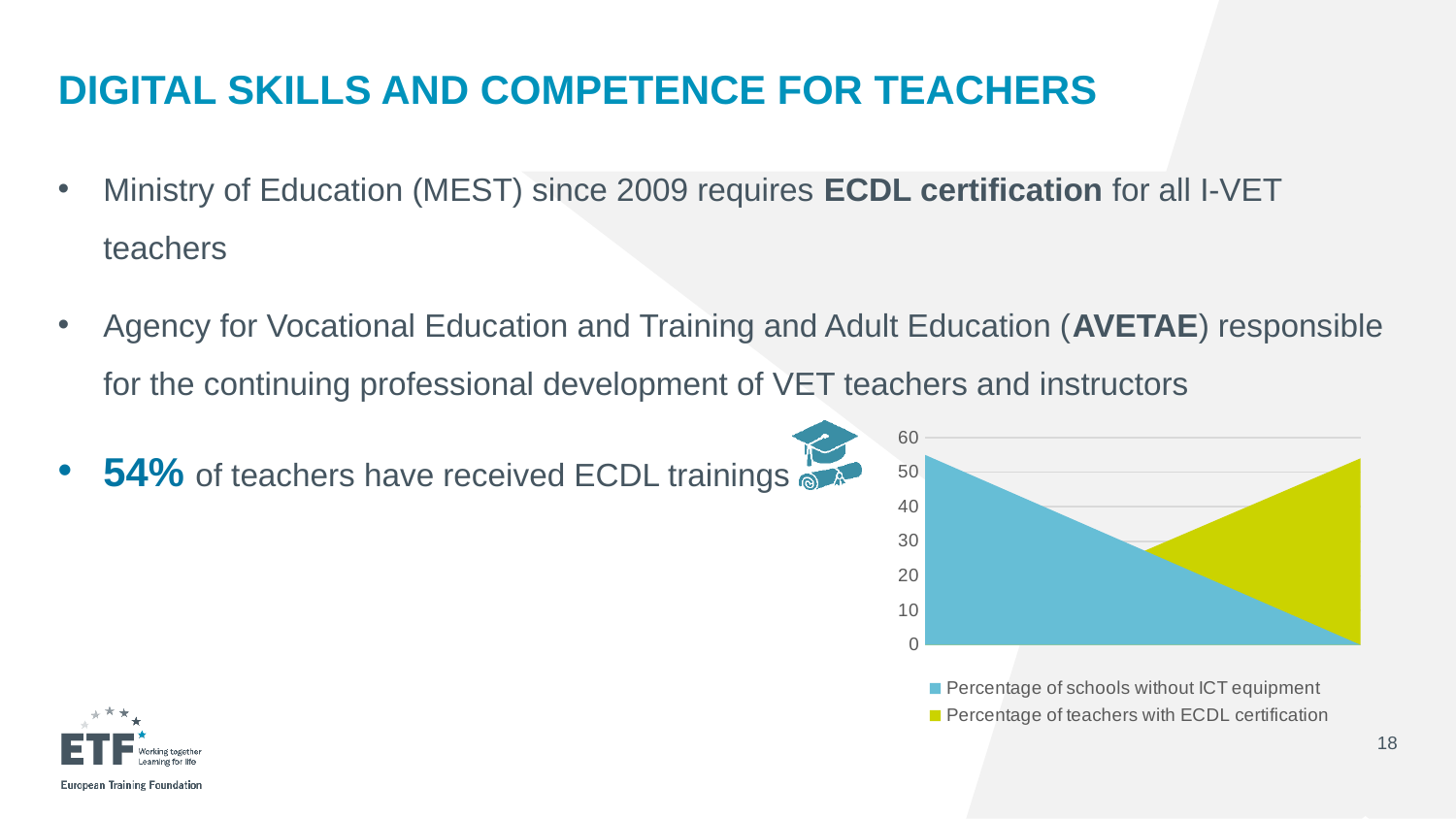
At the right edge of the chart, which series has the larger value: 'Percentage of schools without ICT equipment' or 'Percentage of teachers with ECDL certification'? Percentage of teachers with ECDL certification What kind of chart is shown on the slide? area chart Does the 'Percentage of schools without ICT equipment' series rise or fall from left to right? fall Is the ending value of 'Percentage of teachers with ECDL certification' at the right of the chart greater or less than 40? greater Is the starting value of 'Percentage of teachers with ECDL certification' at the left of the chart greater or less than 10? less Is the starting value of 'Percentage of schools without ICT equipment' at the left of the chart greater or less than 40? greater Does the 'Percentage of teachers with ECDL certification' series rise or fall from left to right? rise At the left edge of the chart, which series has the larger value: 'Percentage of schools without ICT equipment' or 'Percentage of teachers with ECDL certification'? Percentage of schools without ICT equipment What colour represents 'Percentage of teachers with ECDL certification' in the chart? yellow-green How many series does the chart legend list? 2 What is the highest value shown on the chart's vertical axis? 60